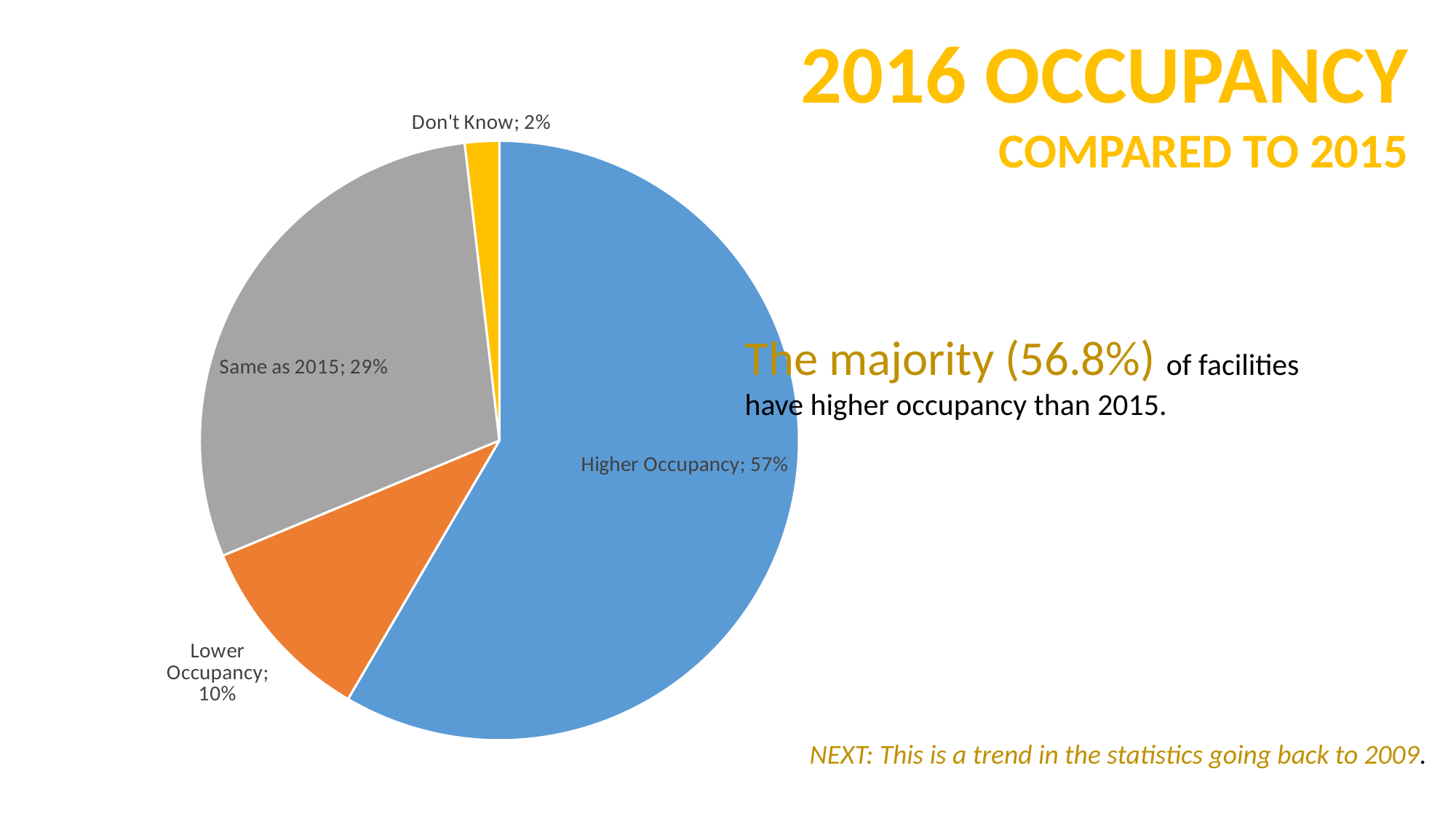
Which is larger, the share for Same as 2015 or the share for Lower Occupancy? Same as 2015 Which category has the largest share of the pie? Higher Occupancy Which category has the smallest share of the pie? Don't Know What colour is the Higher Occupancy slice? blue What kind of chart is shown on the slide? pie chart What is the difference in percentage points between Higher Occupancy and Same as 2015? 28 What is the combined percentage of Lower Occupancy and Don't Know? 12% What percentage of facilities answered Don't Know? 2% What percentage of facilities reported Lower Occupancy? 10% What percentage of facilities reported Higher Occupancy? 57% How many slices does the pie chart have? 4 What percentage of facilities reported Same as 2015? 29%